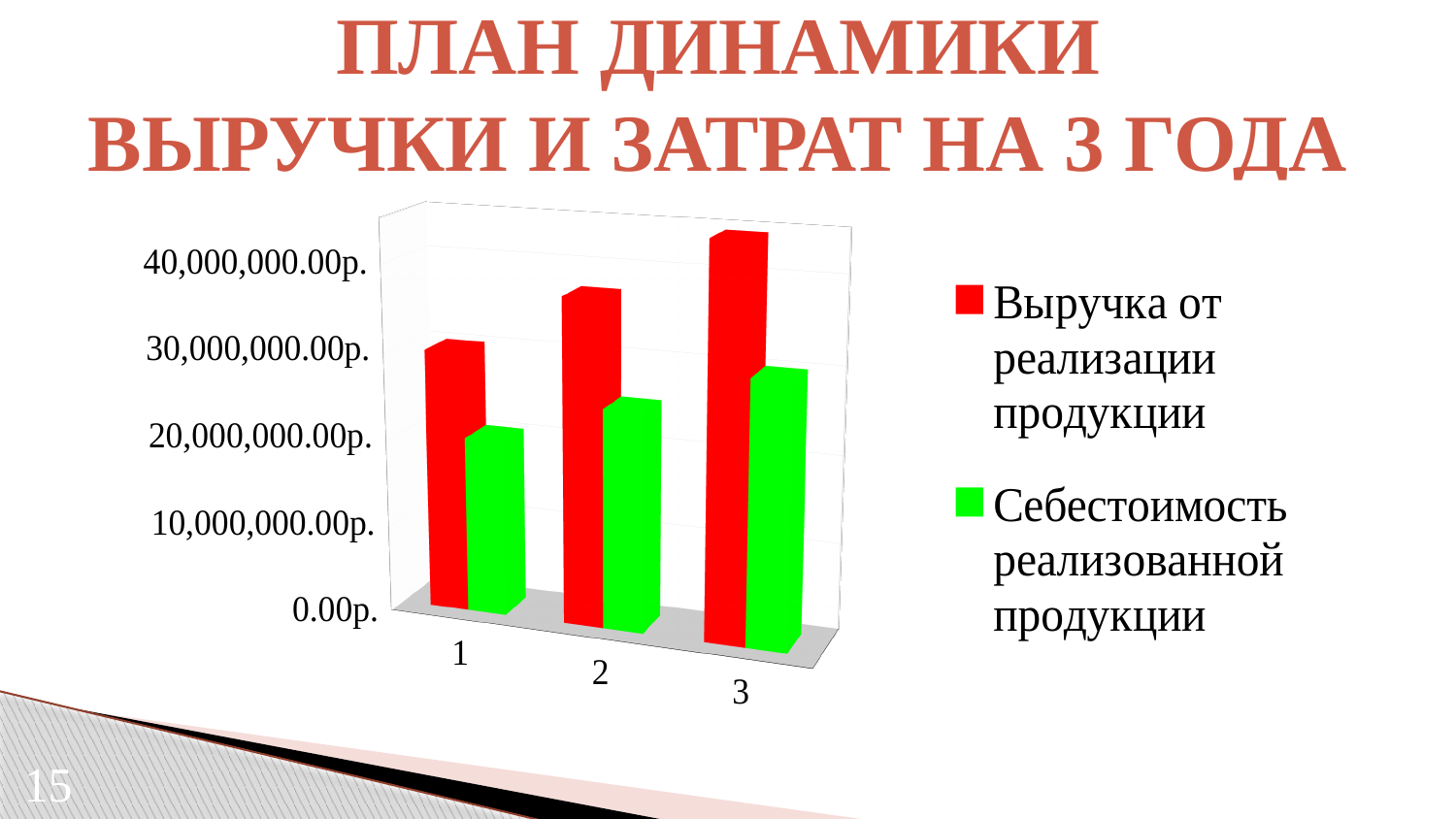
Which category has the highest value for Выручка от реализации продукции? 3 Which category has the lowest value for Себестоимость реализованной продукции? 1 Is the value for Выручка от реализации продукции in category 2 greater or less than 30,000,000.00р.? greater In category 2, which is larger: Выручка от реализации продукции or Себестоимость реализованной продукции? Выручка от реализации продукции Is the value for Себестоимость реализованной продукции in category 2 greater or less than 20,000,000.00р.? greater How many categories are shown on the x axis? 3 Which colour represents Себестоимость реализованной продукции in the legend? green What kind of chart is shown on the slide? bar chart Do the values for Выручка от реализации продукции rise or fall from category 1 to category 3? rise How many series does the legend list? 2 Is the value for Выручка от реализации продукции in category 3 greater or less than 40,000,000.00р.? greater